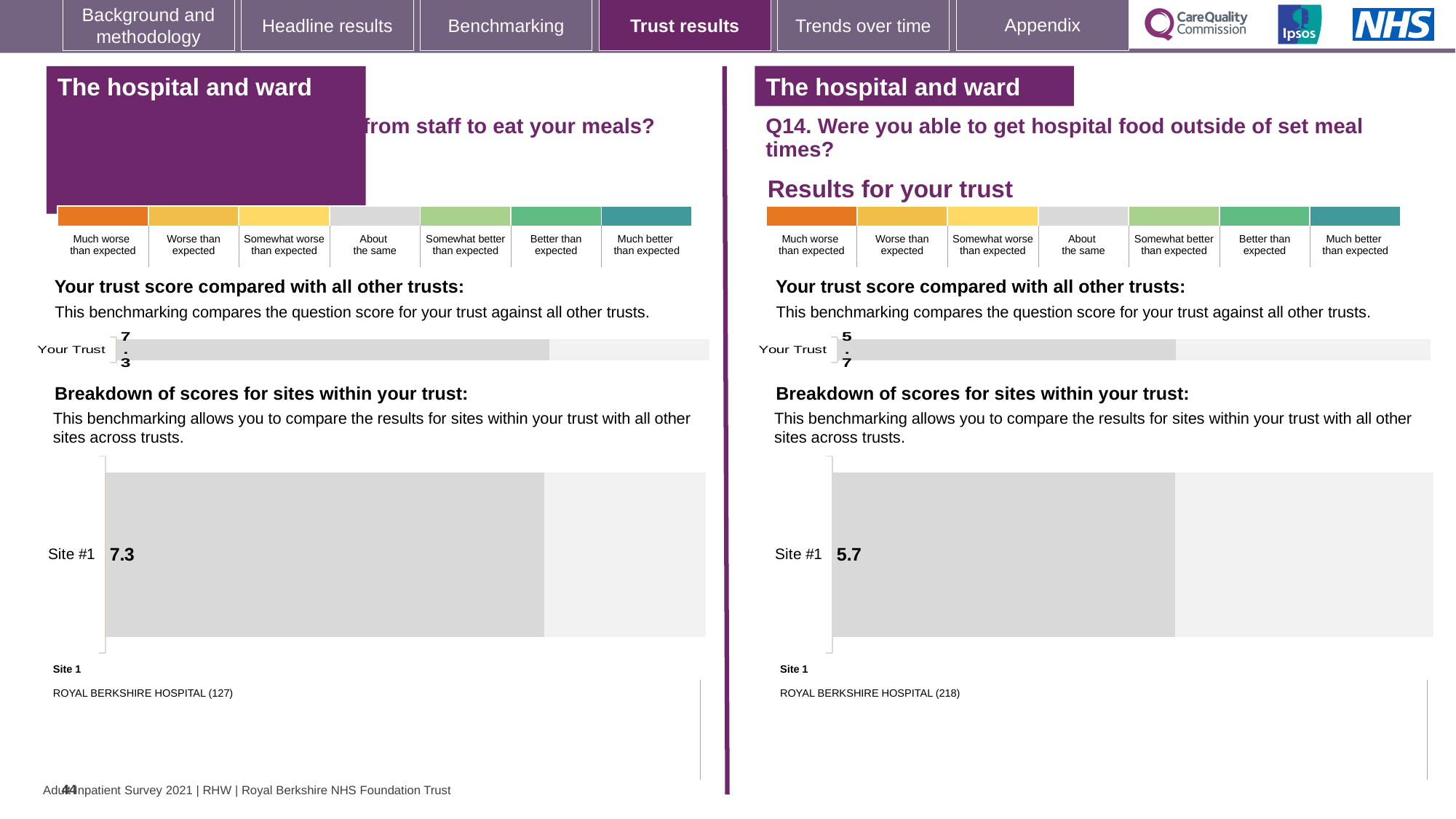
What kind of chart is used for the 'Breakdown of scores for sites within your trust' on the right half of the slide (Q14)? Bar chart On the left half of the slide, what is the 'Your Trust' score shown in the trust score bar chart? 7.3 In the 'Breakdown of scores for sites within your trust' chart on the right half of the slide (Q14), what is the score for Site #1? 5.7 Which site is labelled as Site 1 in the breakdown chart on the right half of the slide (Q14)? ROYAL BERKSHIRE HOSPITAL (218) What is the difference between the Site #1 score on the left half of the slide (7.3) and the Site #1 score on the right half (5.7)? 1.6 Which is larger: the Site #1 score in the left-hand breakdown chart or the Site #1 score in the right-hand (Q14) breakdown chart? Left-hand chart (7.3) In the 'Breakdown of scores for sites within your trust' chart on the left half of the slide, what is the score for Site #1? 7.3 Which site is labelled as Site 1 in the breakdown chart on the left half of the slide? ROYAL BERKSHIRE HOSPITAL (127) On the right half of the slide (Q14), what is the 'Your Trust' score shown in the trust score bar chart? 5.7 Is the 'Your Trust' score on the right half of the slide (Q14) greater or less than the 'Your Trust' score on the left half of the slide? less What kind of chart is used to show the 'Your Trust' score on the left half of the slide? Bar chart How many sites are plotted in the 'Breakdown of scores for sites within your trust' chart on the right half of the slide (Q14)? 1